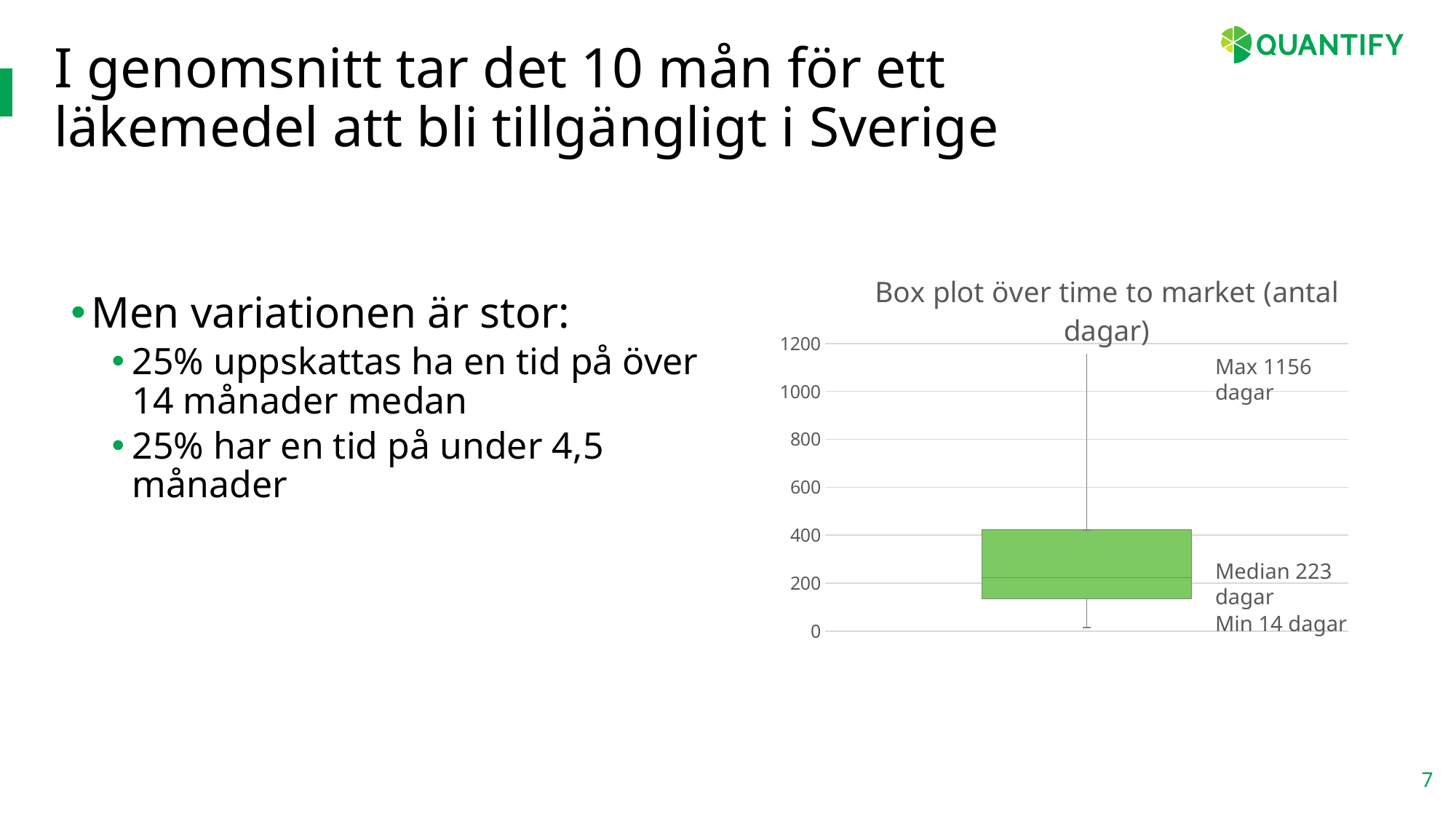
What is the difference between the maximum and the minimum value on the box plot? 1142 dagar Is the bottom of the box (lower quartile) greater or less than 200? less What is the median value shown on the box plot? 223 dagar What is the maximum value shown on the box plot? 1156 dagar Is the top of the box (upper quartile) greater or less than 600? less Is the median of the box plot greater or less than 400? less What is the minimum value shown on the box plot? 14 dagar What is the difference between the maximum and the median value on the box plot? 933 dagar What is the title of the chart? Box plot över time to market (antal dagar) What is the difference between the median and the minimum value on the box plot? 209 dagar What kind of chart is shown on the slide? Box plot What is the highest value labelled on the vertical axis of the chart? 1200